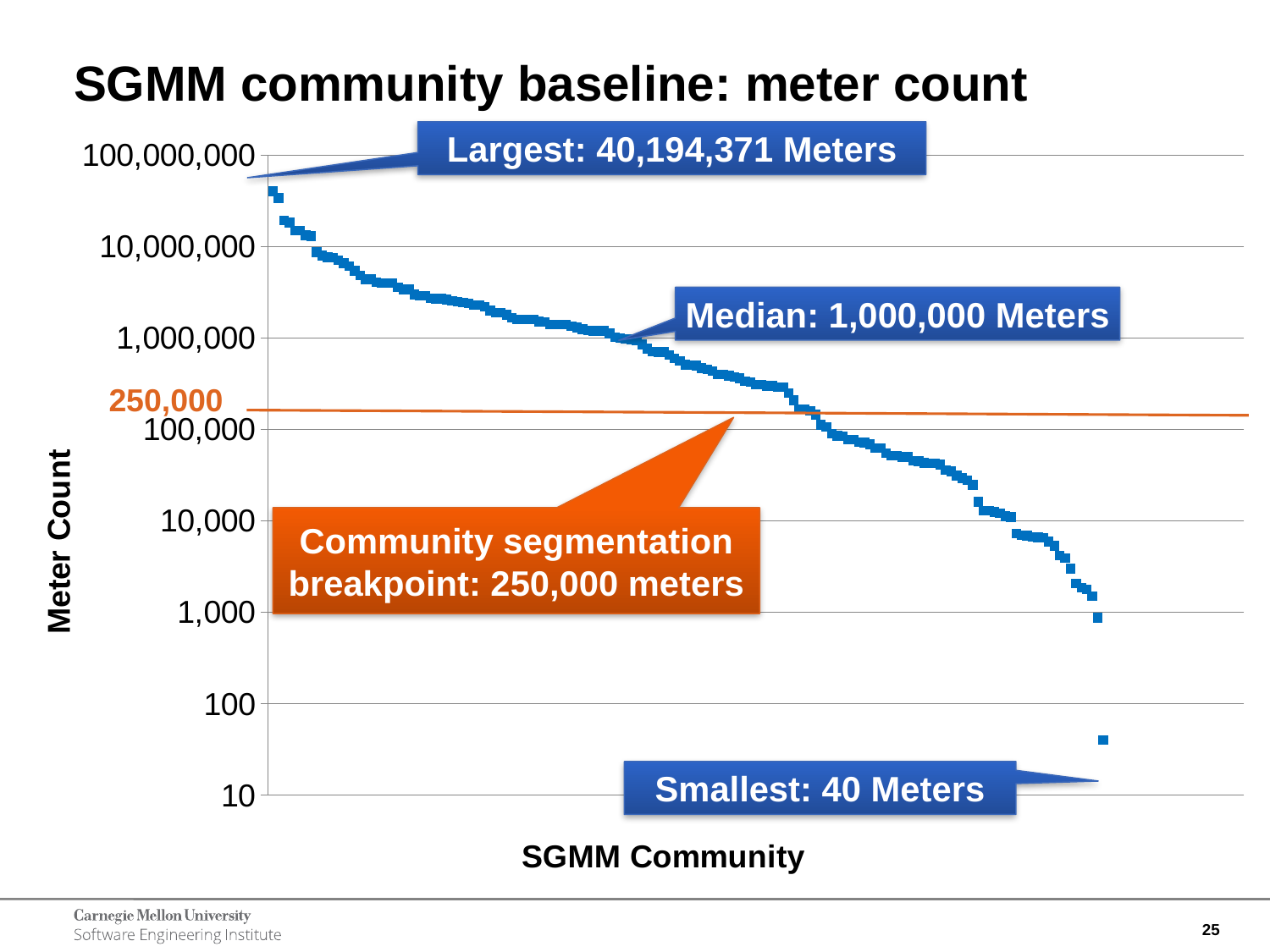
What is the median meter count labeled on the chart? 1,000,000 Meters At what meter count is the community segmentation breakpoint drawn on the chart? 250,000 meters What is the difference in meters between the largest and smallest communities labeled on the chart? 40,194,331 What is the meter count of the largest SGMM community, as labeled on the chart? 40,194,371 Meters What kind of chart is shown on the slide? scatter chart Which is larger, the median meter count or the community segmentation breakpoint? the median meter count Do the plotted meter counts rise or fall from left to right along the x axis? fall Is the meter count of the largest community greater or less than 10,000,000? greater What is the meter count of the smallest SGMM community, as labeled on the chart? 40 Meters What is the title of the chart on the slide? SGMM community baseline: meter count Is the meter count of the smallest community greater or less than 100? less What is the label of the y axis? Meter Count